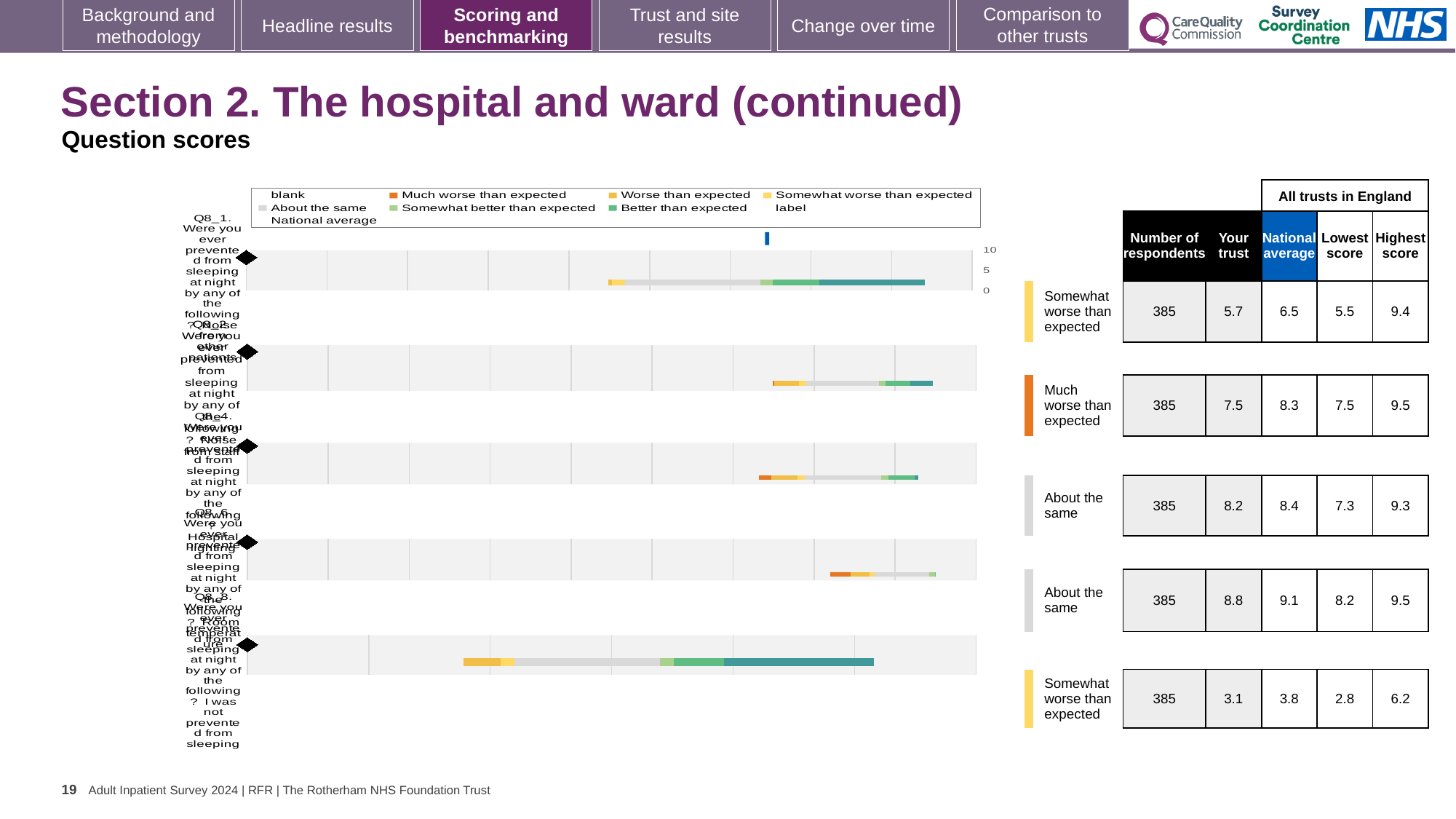
In the table, what is the 'Your trust' score in the first row (Q8_1)? 5.7 In the third row (Q8_4), is the 'Your trust' score or the national average larger? national average In the chart legend, what colour represents 'Much worse than expected'? orange In the table, what is the highest score across all trusts in England in the fifth row (Q8_8)? 6.2 Which table row has the lowest 'Your trust' score? the fifth row (Q8_8), 3.1 How many horizontal bars (question rows) are plotted in the chart? 5 In the fourth row (Q8_6), what is the difference between the national average (9.1) and the 'Your trust' score (8.8)? 0.3 In the table, what is the national average in the second row (Q8_2)? 8.3 How many respondents are listed in each row of the table? 385 What kind of chart is shown on the left of the slide? bar chart Which table row has the highest 'Your trust' score? the fourth row (Q8_6), 8.8 In the chart legend, what colour represents 'Better than expected'? teal